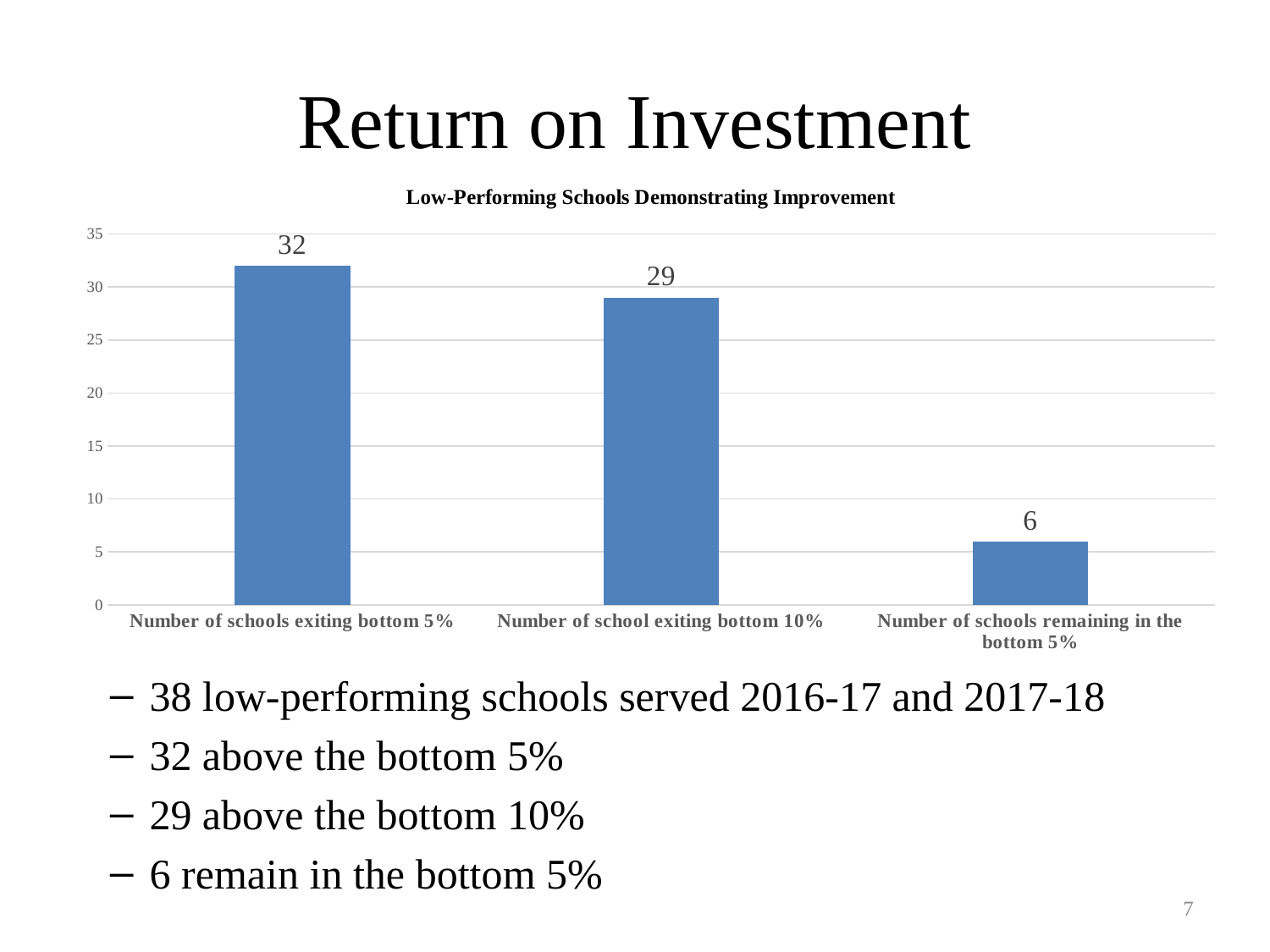
What is the value for 'Number of schools exiting bottom 5%'? 32 What kind of chart is shown on the slide? bar chart What is the difference between the value for 'Number of school exiting bottom 10%' and the value for 'Number of schools remaining in the bottom 5%'? 23 Is the value for 'Number of schools remaining in the bottom 5%' greater or less than 10? less How many categories are shown in the chart? 3 What is the difference between the value for 'Number of schools exiting bottom 5%' and the value for 'Number of school exiting bottom 10%'? 3 Which category has the highest value? Number of schools exiting bottom 5% What is the title of the chart? Low-Performing Schools Demonstrating Improvement What is the value for 'Number of schools remaining in the bottom 5%'? 6 Which is larger: the value for 'Number of schools exiting bottom 5%' or the value for 'Number of schools remaining in the bottom 5%'? Number of schools exiting bottom 5% Which category has the lowest value? Number of schools remaining in the bottom 5% What is the value for 'Number of school exiting bottom 10%'? 29